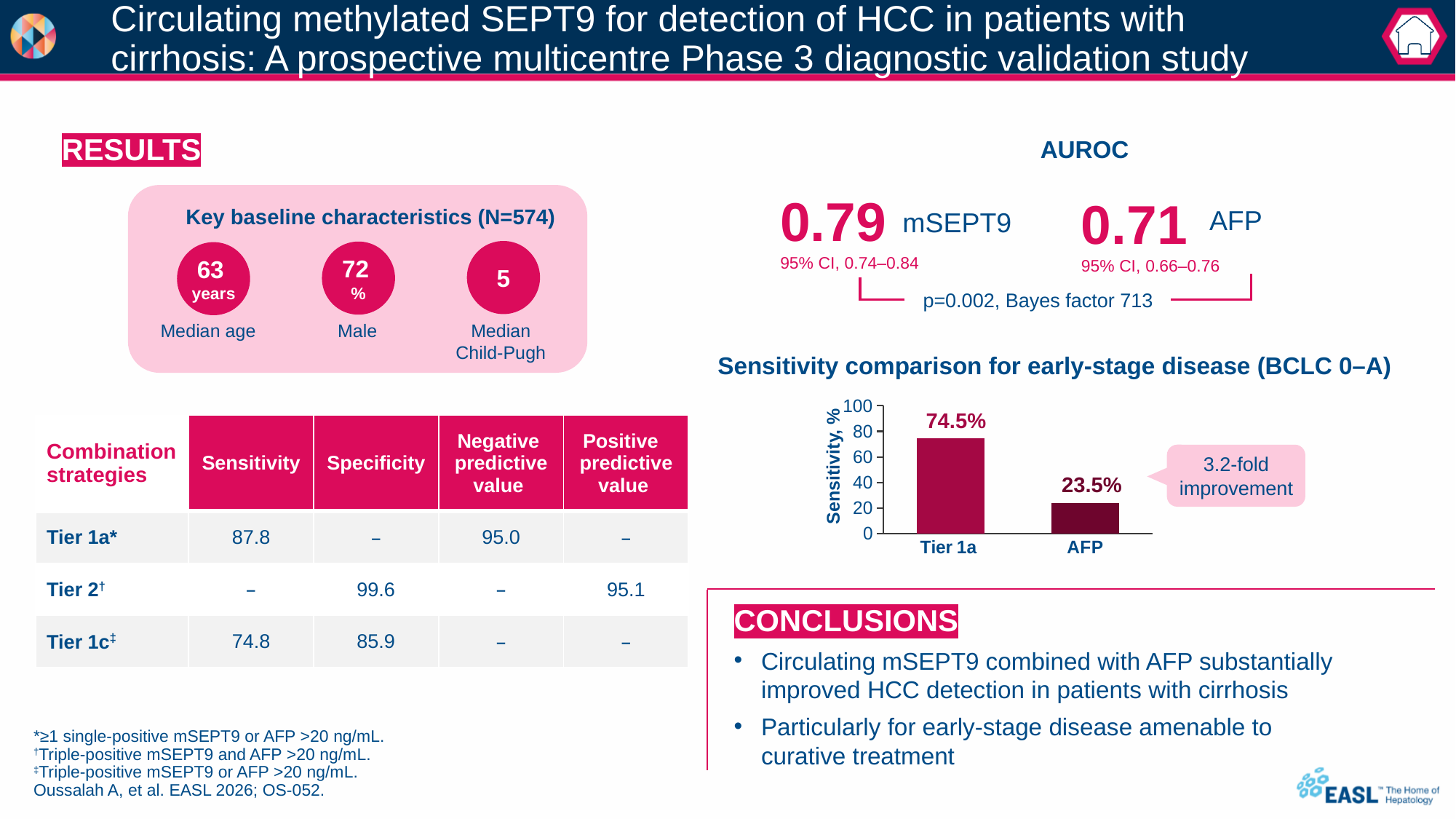
How many categories are plotted in the bar chart? 2 What is the difference in sensitivity between Tier 1a and AFP in the bar chart? 51.0 percentage points Is the sensitivity for Tier 1a in the bar chart greater or less than 60? greater What type of chart is used to show the sensitivity comparison for early-stage disease? Bar chart What is the sensitivity value shown for Tier 1a in the bar chart? 74.5% Which has a larger sensitivity in the bar chart, Tier 1a or AFP? Tier 1a Which category has the lowest sensitivity in the bar chart? AFP Is the sensitivity for AFP in the bar chart greater or less than 40? less What is the sensitivity value shown for AFP in the bar chart? 23.5% Which category has the highest sensitivity in the bar chart? Tier 1a What is the title of the chart on the slide? Sensitivity comparison for early-stage disease (BCLC 0–A) What is the label of the y-axis in the bar chart? Sensitivity, %